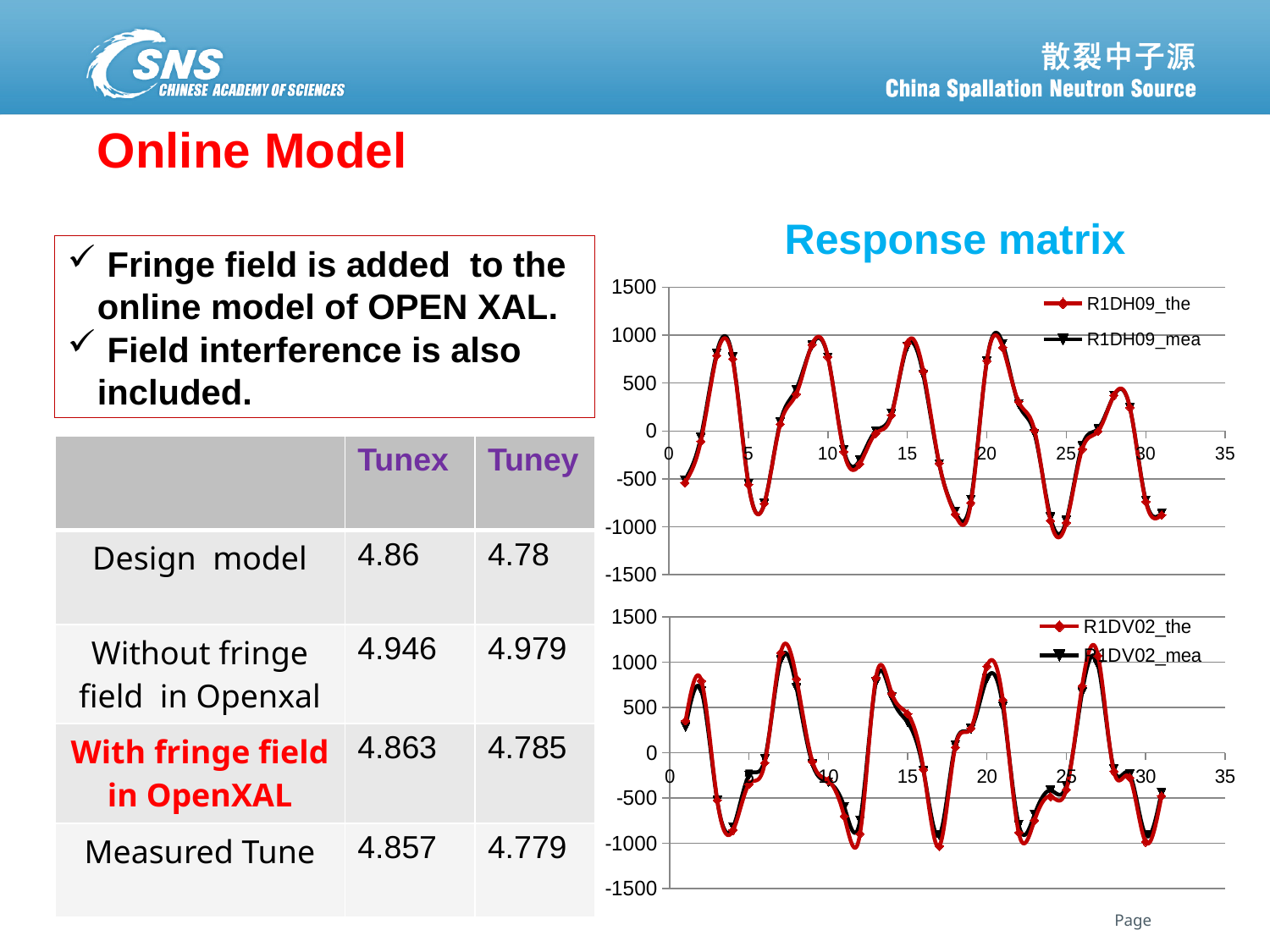
In the top chart, is the value of the R1DH09_the series at its first peak (near x = 3) greater or less than 500? greater In the top chart, what is the highest value shown on the vertical axis? 1500 In the top chart, what are the two series named in the legend? R1DH09_the and R1DH09_mea In the bottom chart, which series is drawn in red according to the legend? R1DV02_the In the top chart, is the value of the R1DH09_the series at its trough near x = 18 greater or less than -500? less In the bottom chart, what is the lowest value shown on the vertical axis? -1500 How many series does the legend of the top chart (R1DH09) list? 2 In the top chart, what is the largest tick value shown on the horizontal axis? 35 In the bottom chart, is the value of the R1DV02_the series at its trough near x = 12 greater or less than -500? less What kind of chart is the bottom chart under the 'Response matrix' heading? line chart How many series does the legend of the bottom chart (R1DV02) list? 2 What kind of chart is the top chart under the 'Response matrix' heading? line chart